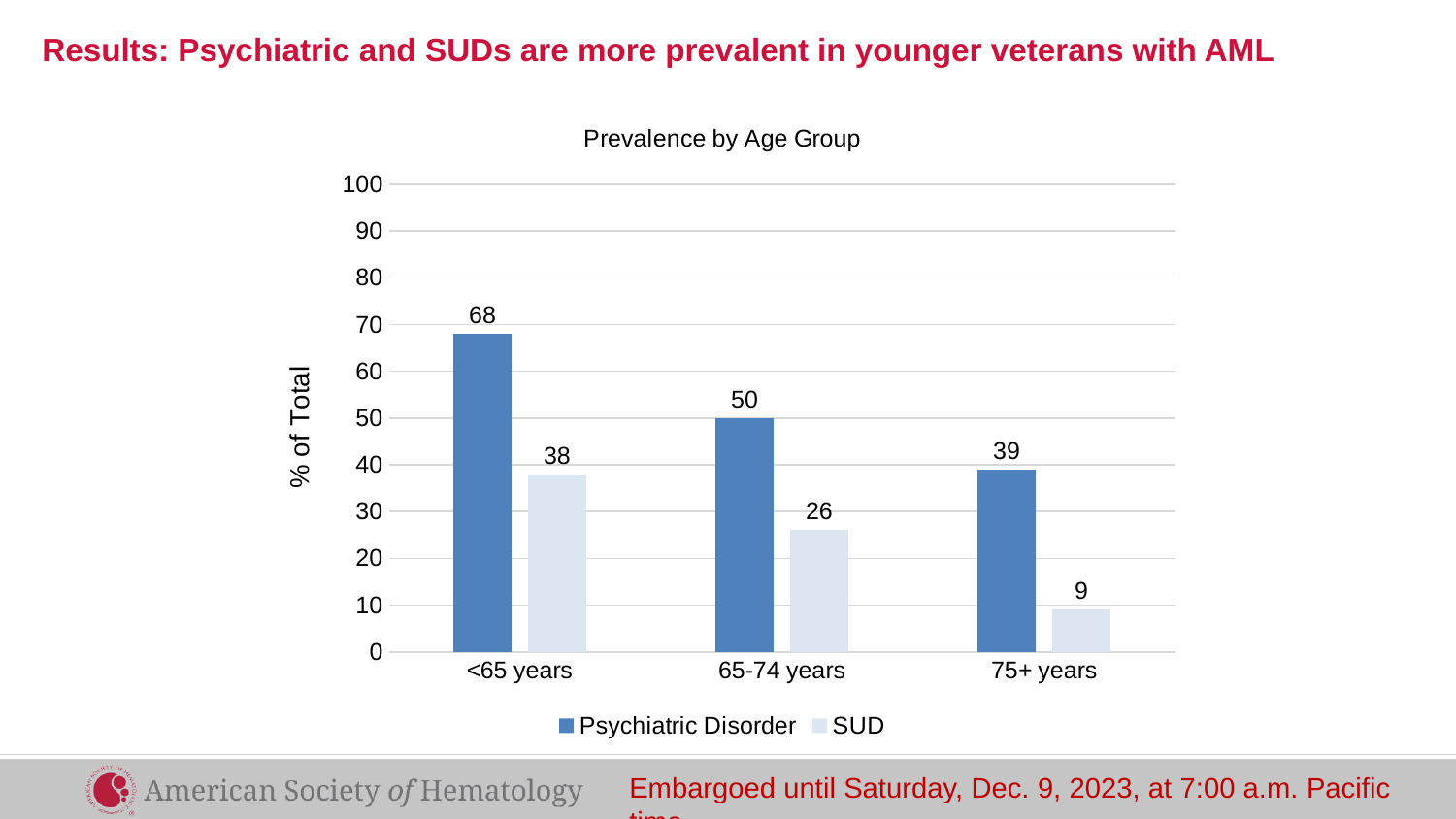
Which age group has the lowest SUD value? 75+ years Do the SUD values rise or fall as age group increases along the x axis? Fall How many series does the legend list? 2 What is the difference between the Psychiatric Disorder values for <65 years and 75+ years? 29 What is the difference between the Psychiatric Disorder and SUD values in the <65 years group? 30 Which age group has the highest Psychiatric Disorder value? <65 years What kind of chart is shown? Bar chart Which is larger: SUD for <65 years or Psychiatric Disorder for 75+ years? Psychiatric Disorder for 75+ years How many age groups are shown on the x axis? 3 What is the value for Psychiatric Disorder in the <65 years group? 68 What is the value for SUD in the 75+ years group? 9 What is the value for SUD in the 65-74 years group? 26